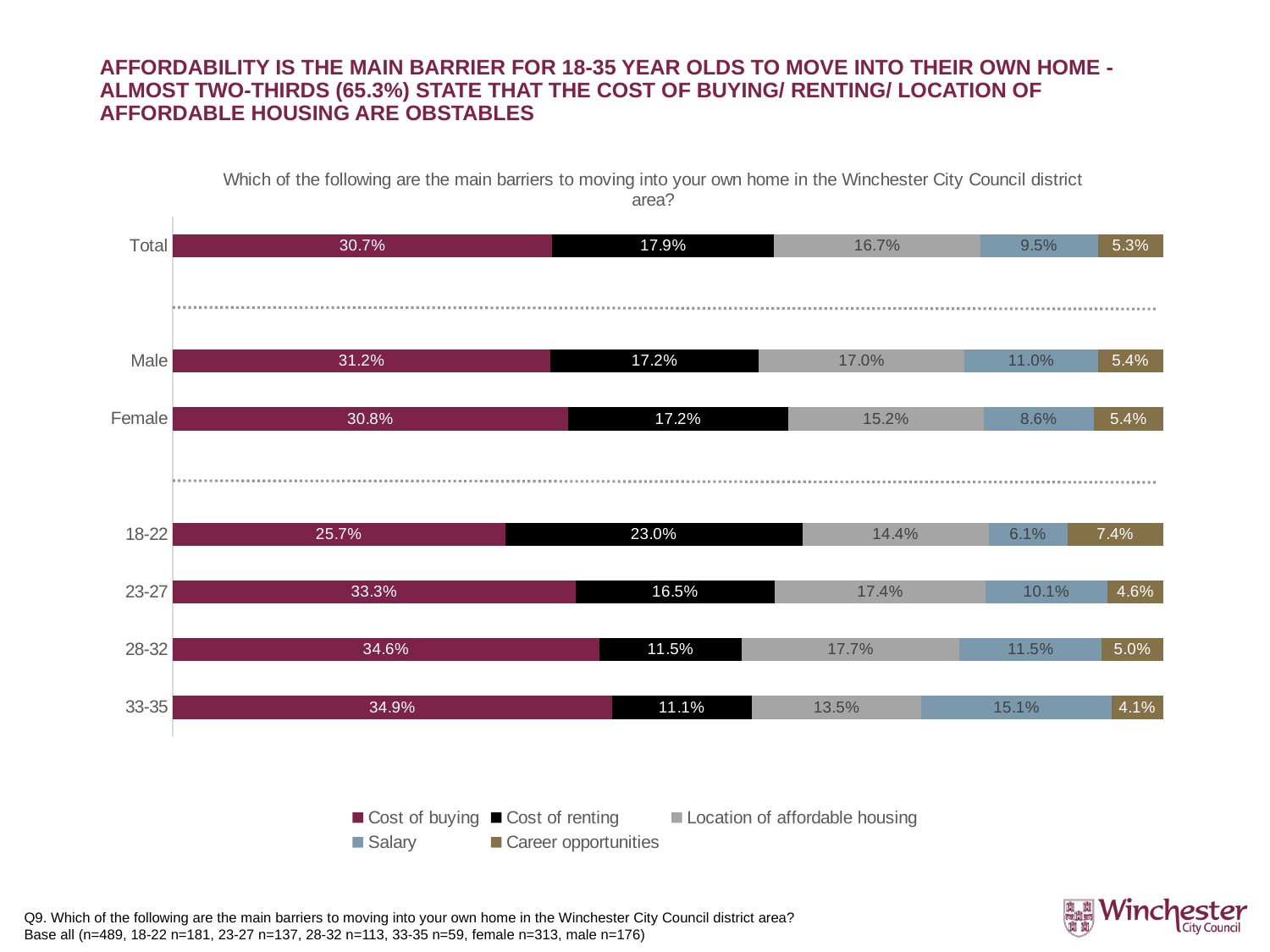
How many series does the legend list? 5 Which category has the highest Cost of renting value? 18-22 Which is larger, the Salary value for Male or for Female? Male Which category has the highest Cost of buying value? 33-35 How many categories (bars) are plotted on the chart? 7 What is the difference between the Cost of buying and Cost of renting values for the Total bar? 12.8 percentage points What is the Salary value for the 33-35 age group? 15.1% What is the total of the stacked bar for the 18-22 age group? 76.6% What type of chart is shown on the slide? Stacked bar chart What is the Career opportunities value for the 18-22 age group? 7.4% What is the Cost of buying value for the Total bar? 30.7% Which category has the lowest Cost of buying value? 18-22